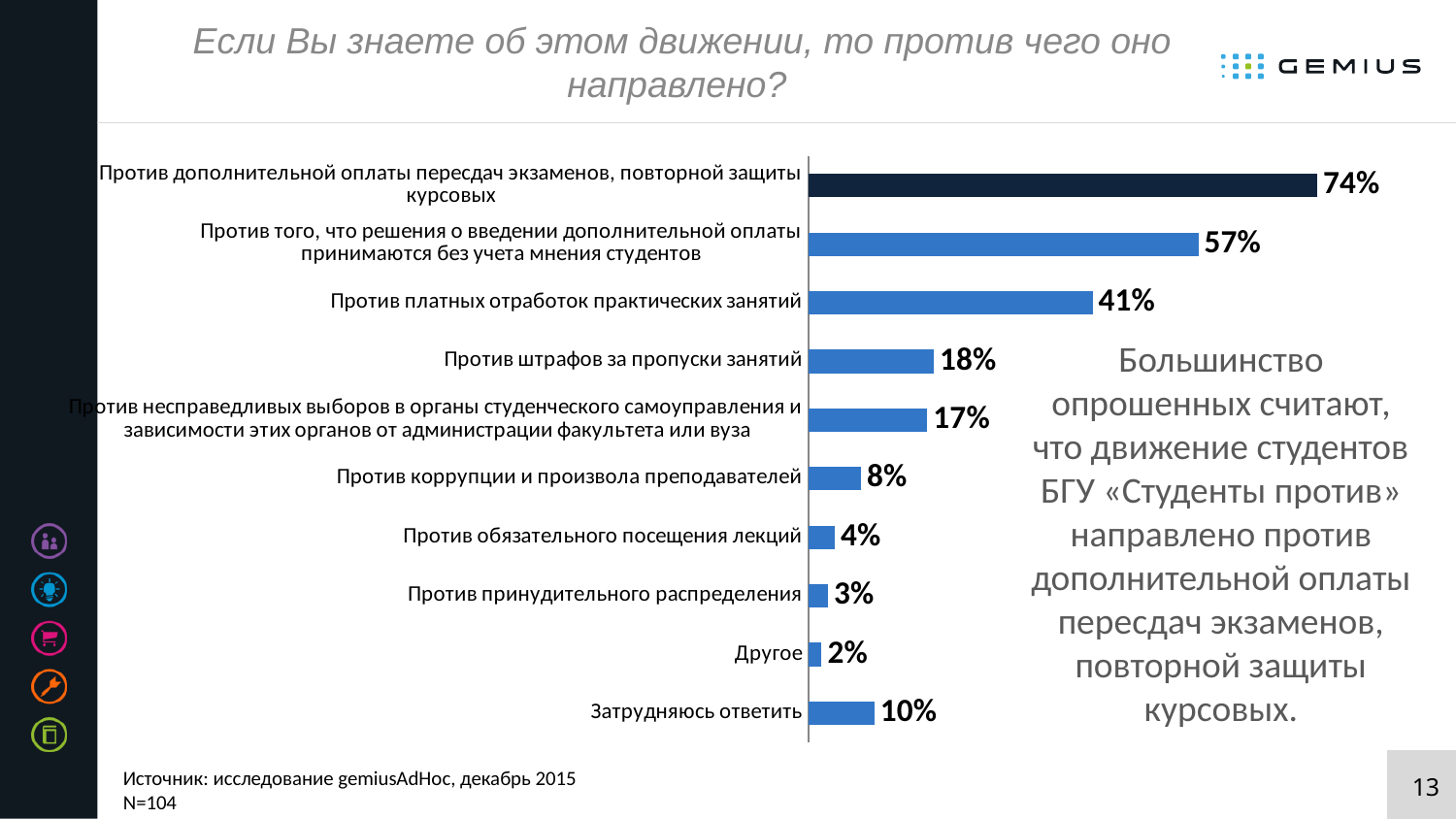
What is the value for "Против платных отработок практических занятий"? 41% What kind of chart is shown on the slide? Bar chart Which category has the highest value? Против дополнительной оплаты пересдач экзаменов, повторной защиты курсовых Which bar is shown in a different (darker) colour from the others? Против дополнительной оплаты пересдач экзаменов, повторной защиты курсовых What is the difference between the values for "Против дополнительной оплаты пересдач экзаменов, повторной защиты курсовых" and "Против того, что решения о введении дополнительной оплаты принимаются без учета мнения студентов"? 17% Which is larger: the value for "Против коррупции и произвола преподавателей" or the value for "Против обязательного посещения лекций"? Против коррупции и произвола преподавателей How many categories are shown in the chart? 10 What is the value for "Против штрафов за пропуски занятий"? 18% What is the value for "Другое"? 2% Which category has the lowest value? Другое What is the difference between the values for "Против штрафов за пропуски занятий" and "Против несправедливых выборов в органы студенческого самоуправления и зависимости этих органов от администрации факультета или вуза"? 1% What is the value for "Затрудняюсь ответить"? 10%